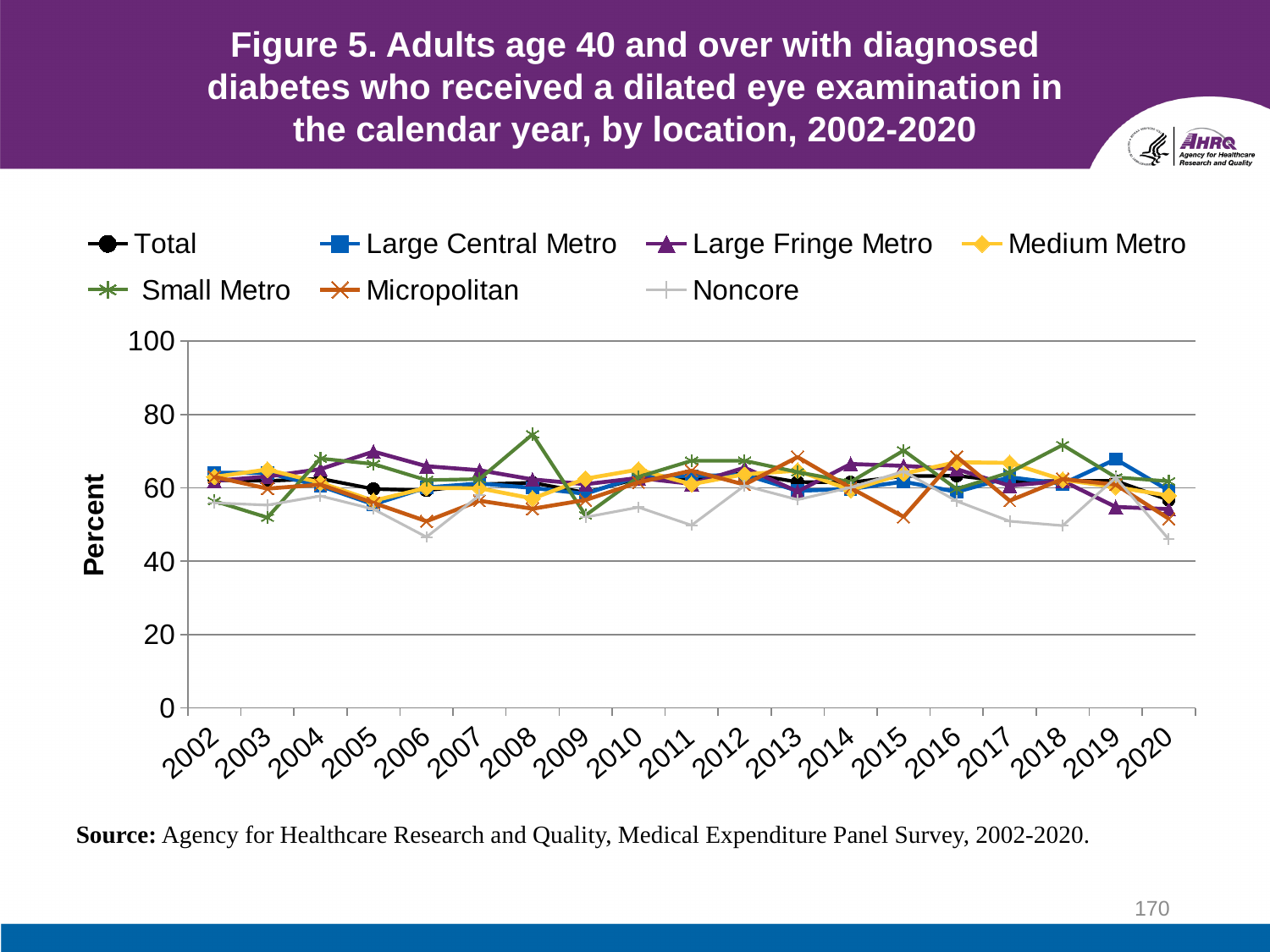
Is the value for Micropolitan in 2015 greater or less than 60? less Which series has the highest value in 2008? Small Metro How many years are plotted along the x axis? 19 How many series does the legend list? 7 Which series has the lowest value in 2020? Noncore Is the value for Small Metro in 2008 greater or less than 60? greater What is the label on the vertical axis? Percent Is the value for Noncore in 2020 greater or less than 60? less What kind of chart is shown on the slide? line chart